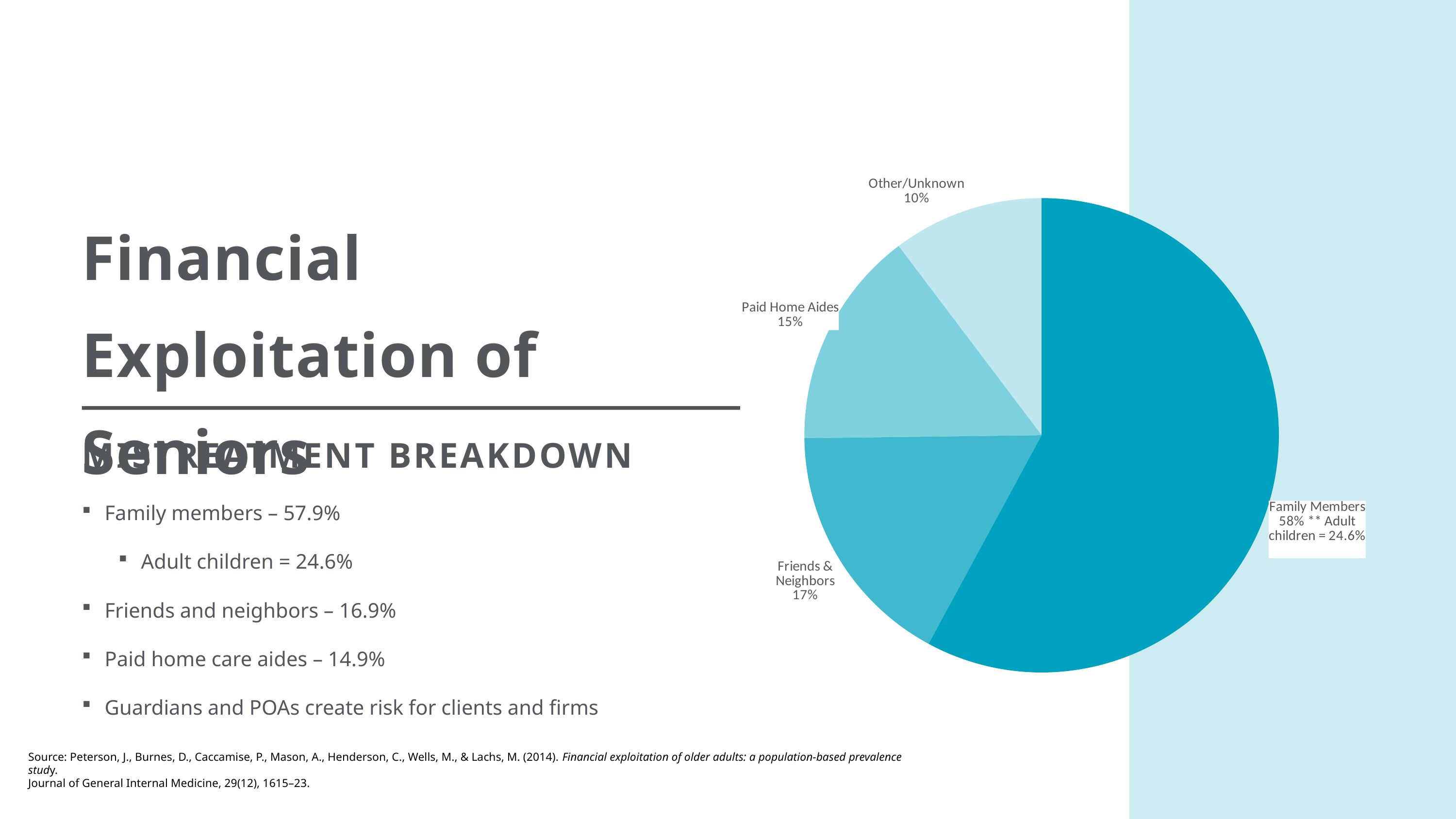
Which slice of the pie chart is the largest? Family Members What percentage does the pie chart show for Family Members? 58% What additional note is printed in the Family Members label of the pie chart? ** Adult children = 24.6% What is the difference in percentage points between the Family Members slice and the Friends & Neighbors slice? 41 What kind of chart is shown on the slide? pie chart Which is larger in the pie chart, Paid Home Aides or Other/Unknown? Paid Home Aides What percentage does the pie chart show for Friends & Neighbors? 17% How many slices does the pie chart have? 4 What is the combined percentage of the Paid Home Aides and Other/Unknown slices? 25% Which slice of the pie chart is the smallest? Other/Unknown What percentage does the pie chart show for Paid Home Aides? 15% What percentage does the pie chart show for Other/Unknown? 10%